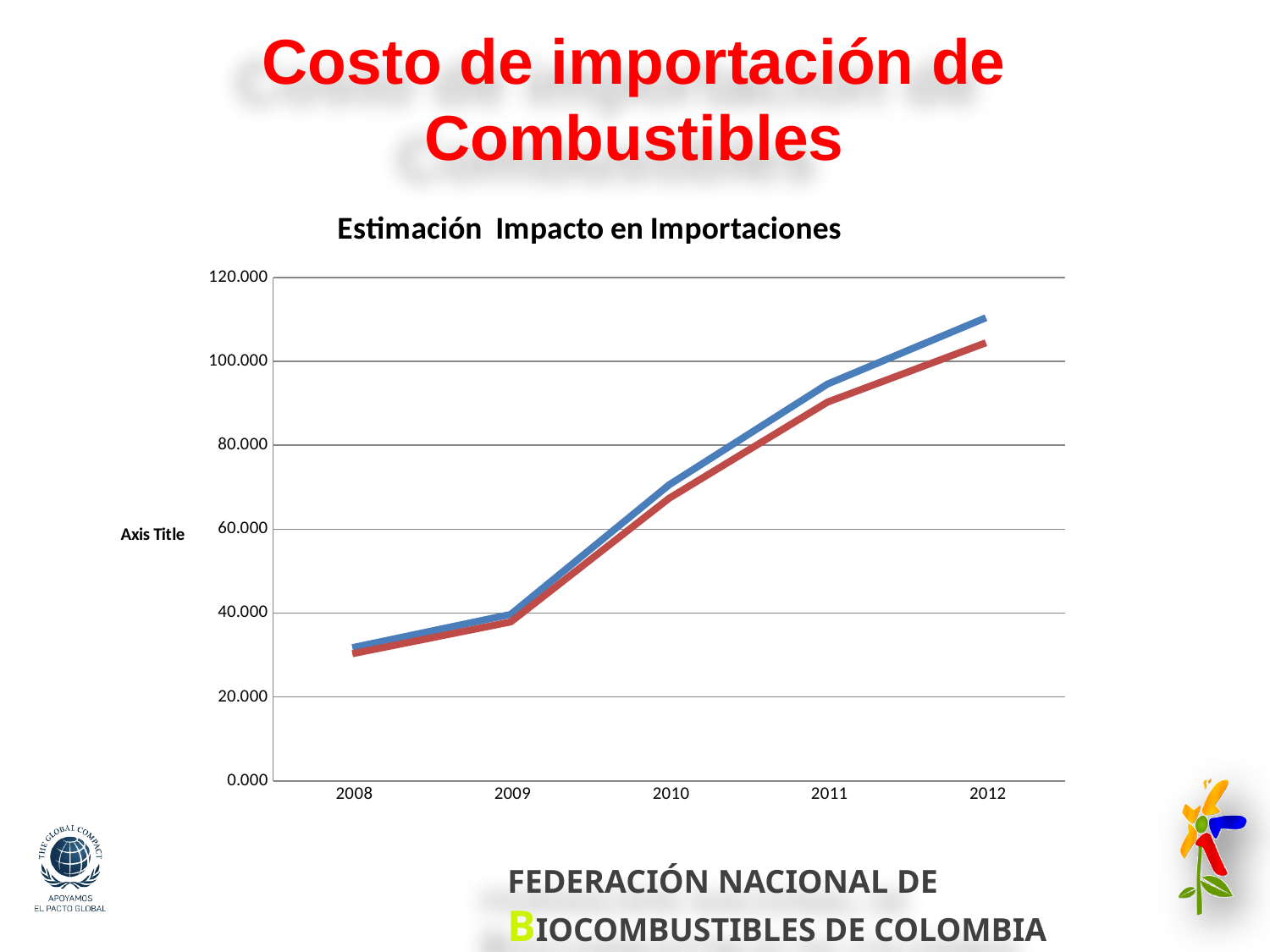
Is the value of the blue line in 2011 greater or less than 80.000? greater What kind of chart is shown on the slide? line chart Do the values of the blue line rise or fall from 2008 to 2012? rise Is the value of the blue line in 2012 greater or less than 100.000? greater In which year does the red line have its lowest value? 2008 Is the value of the red line in 2010 greater or less than 60.000? greater In 2012, which line has the higher value, the blue line or the red line? blue line How many years are shown on the x axis of the chart? 5 In which year does the blue line reach its highest value? 2012 How many lines are plotted on the chart? 2 What is the title of the chart? Estimación Impacto en Importaciones